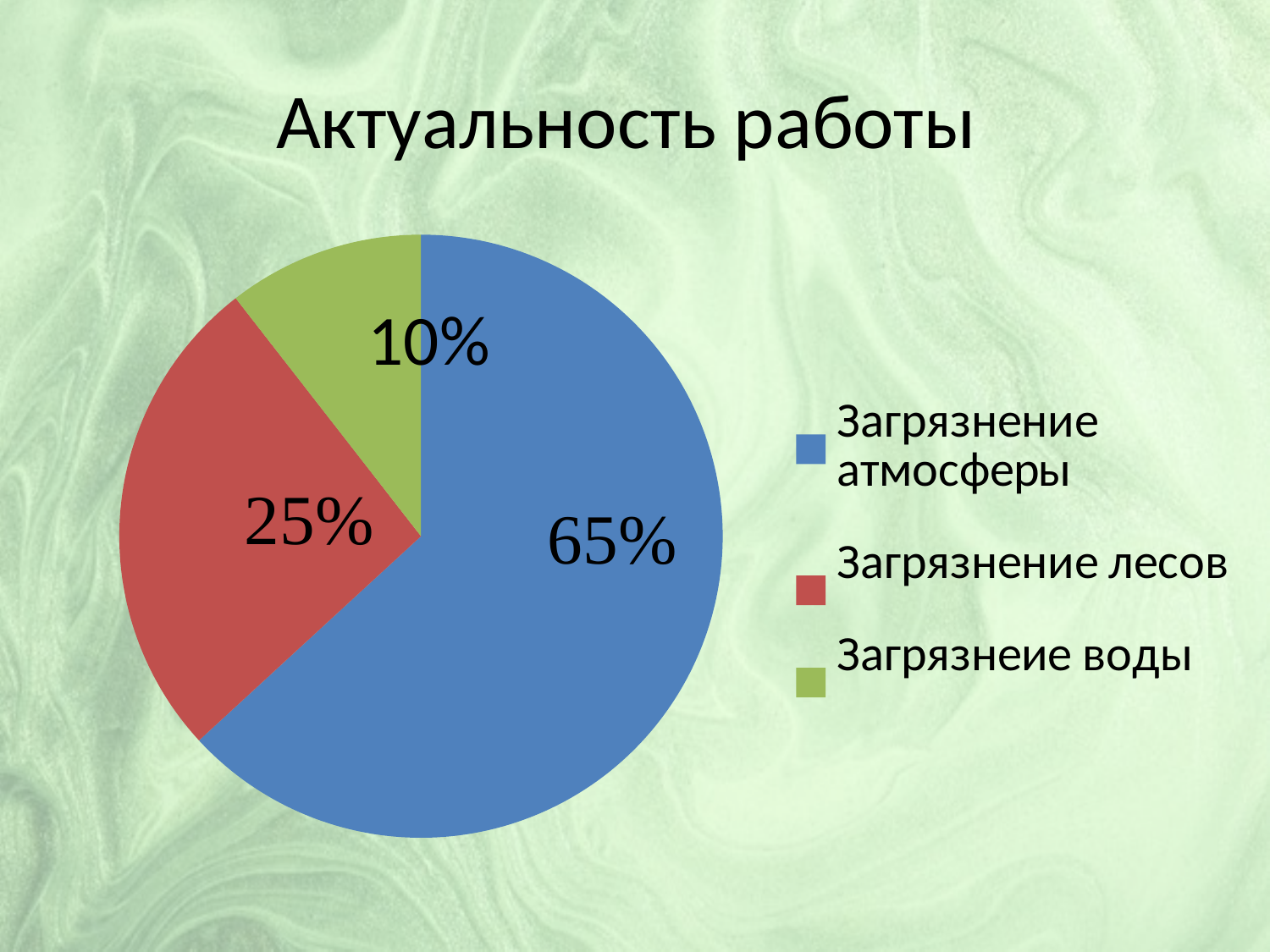
What colour is the slice for Загрязнение лесов? red What is the difference in percentage points between Загрязнение атмосферы and Загрязнение лесов? 40 What is the difference in percentage points between Загрязнение лесов and Загрязнеие воды? 15 Which category has the largest slice of the pie? Загрязнение атмосферы What share of the pie does Загрязнение лесов take? 25% What share of the pie does Загрязнение атмосферы take? 65% What share of the pie does Загрязнеие воды take? 10% Which category has the smallest slice of the pie? Загрязнеие воды Which is larger: the slice for Загрязнение лесов or the slice for Загрязнеие воды? Загрязнение лесов How many slices does the pie chart have? 3 What is the title of the slide containing the chart? Актуальность работы What kind of chart is shown on the slide? pie chart